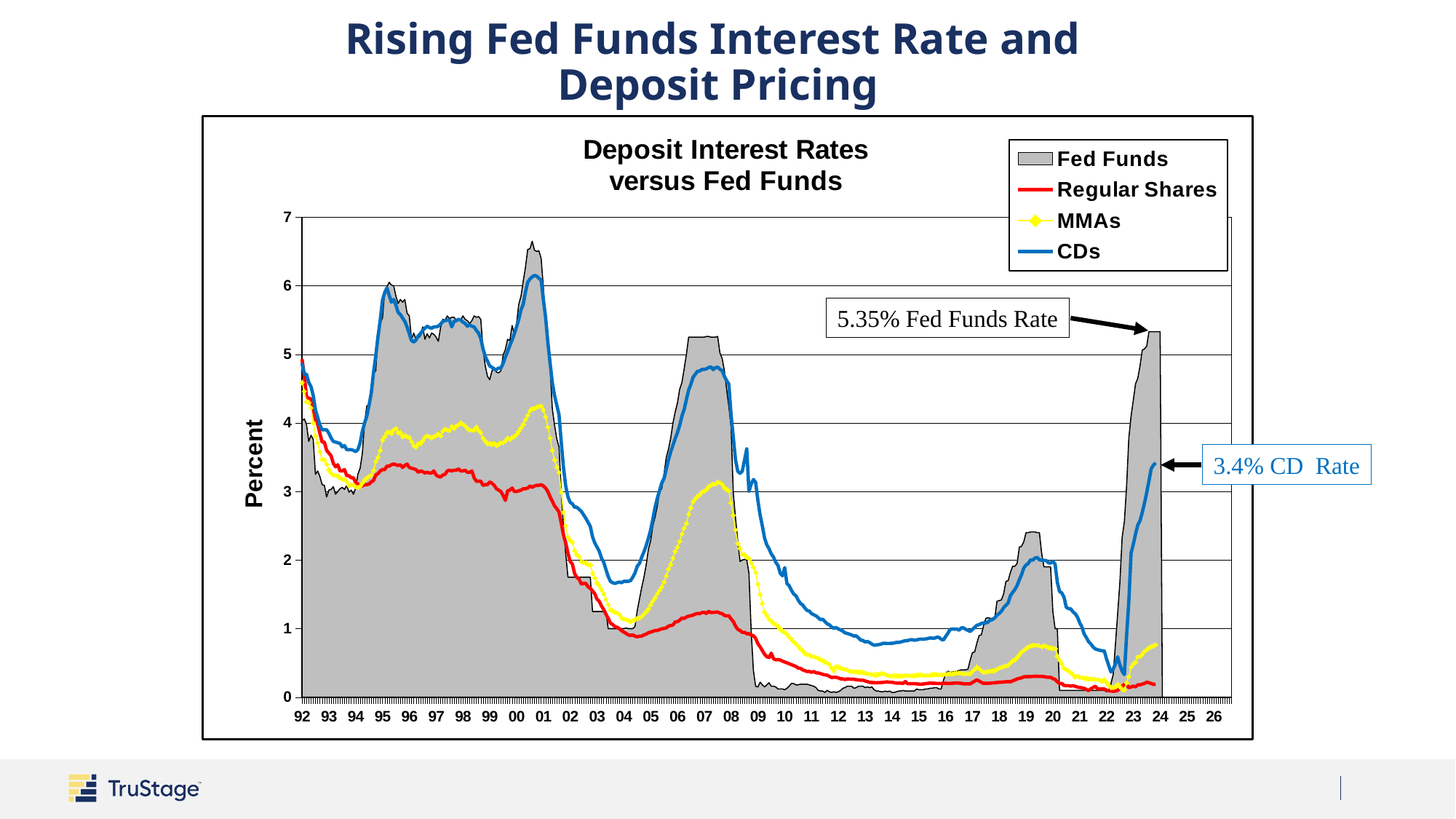
Is the peak Fed Funds value around 2000-01 greater or less than 6? greater What Fed Funds rate is called out by the annotation on the chart? 5.35% Which series is lowest in 2023? Regular Shares What CD rate is called out by the annotation on the chart? 3.4% Is the CDs value in 2007 greater or less than 4? greater What is the title of the chart? Deposit Interest Rates versus Fed Funds What is the difference between the annotated Fed Funds rate and the annotated CD rate? 1.95% Do the CDs values rise or fall from 2022 to 2024? rise Is the Regular Shares value in 2013 greater or less than 1? less How many series does the chart legend list? 4 Which is larger at the end of the chart, the annotated Fed Funds rate or the annotated CD rate? Fed Funds rate What is the label on the vertical axis of the chart? Percent